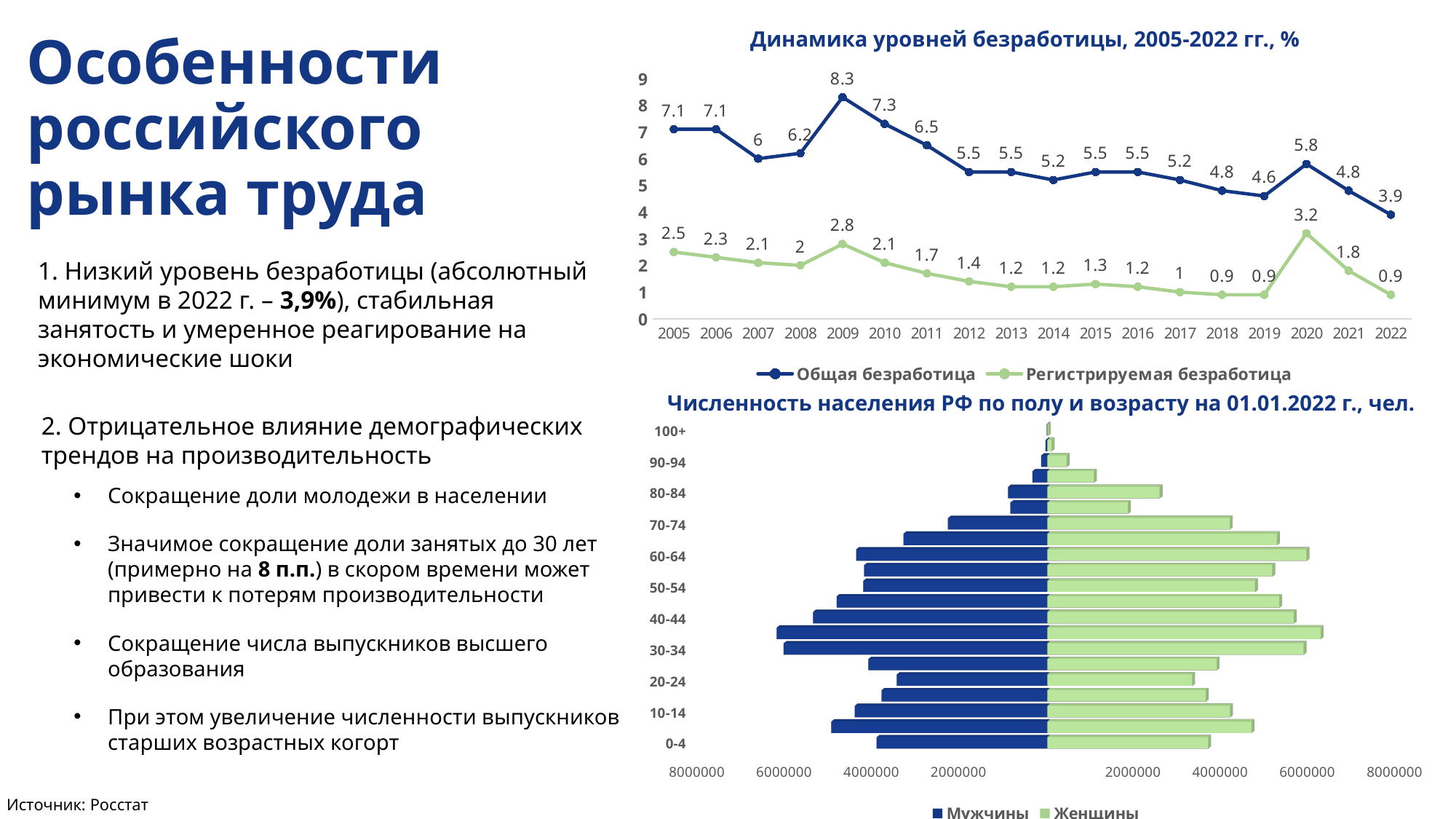
On the chart 'Динамика уровней безработицы, 2005-2022 гг., %', in which year was Общая безработица highest? 2009 On the chart 'Динамика уровней безработицы, 2005-2022 гг., %', what is the difference between Общая безработица and Регистрируемая безработица in 2022? 3 On the chart 'Численность населения РФ по полу и возрасту на 01.01.2022 г., чел.', is the value for Женщины in the 40-44 age group greater or less than 4000000? greater On the chart 'Динамика уровней безработицы, 2005-2022 гг., %', what was the value of Общая безработица in 2009? 8.3 On the chart 'Численность населения РФ по полу и возрасту на 01.01.2022 г., чел.', which colour represents Женщины? light green On the chart 'Динамика уровней безработицы, 2005-2022 гг., %', how many years are shown on the x axis? 18 On the chart 'Численность населения РФ по полу и возрасту на 01.01.2022 г., чел.', is the value for Мужчины in the 80-84 age group greater or less than 2000000? less On the chart 'Динамика уровней безработицы, 2005-2022 гг., %', which was larger in 2020: Общая безработица or Регистрируемая безработица? Общая безработица What kind of chart is 'Динамика уровней безработицы, 2005-2022 гг., %'? line chart On the chart 'Динамика уровней безработицы, 2005-2022 гг., %', what was the value of Регистрируемая безработица in 2020? 3.2 On the chart 'Динамика уровней безработицы, 2005-2022 гг., %', in which year was Общая безработица lowest? 2022 On the chart 'Динамика уровней безработицы, 2005-2022 гг., %', how many series does the legend list? 2